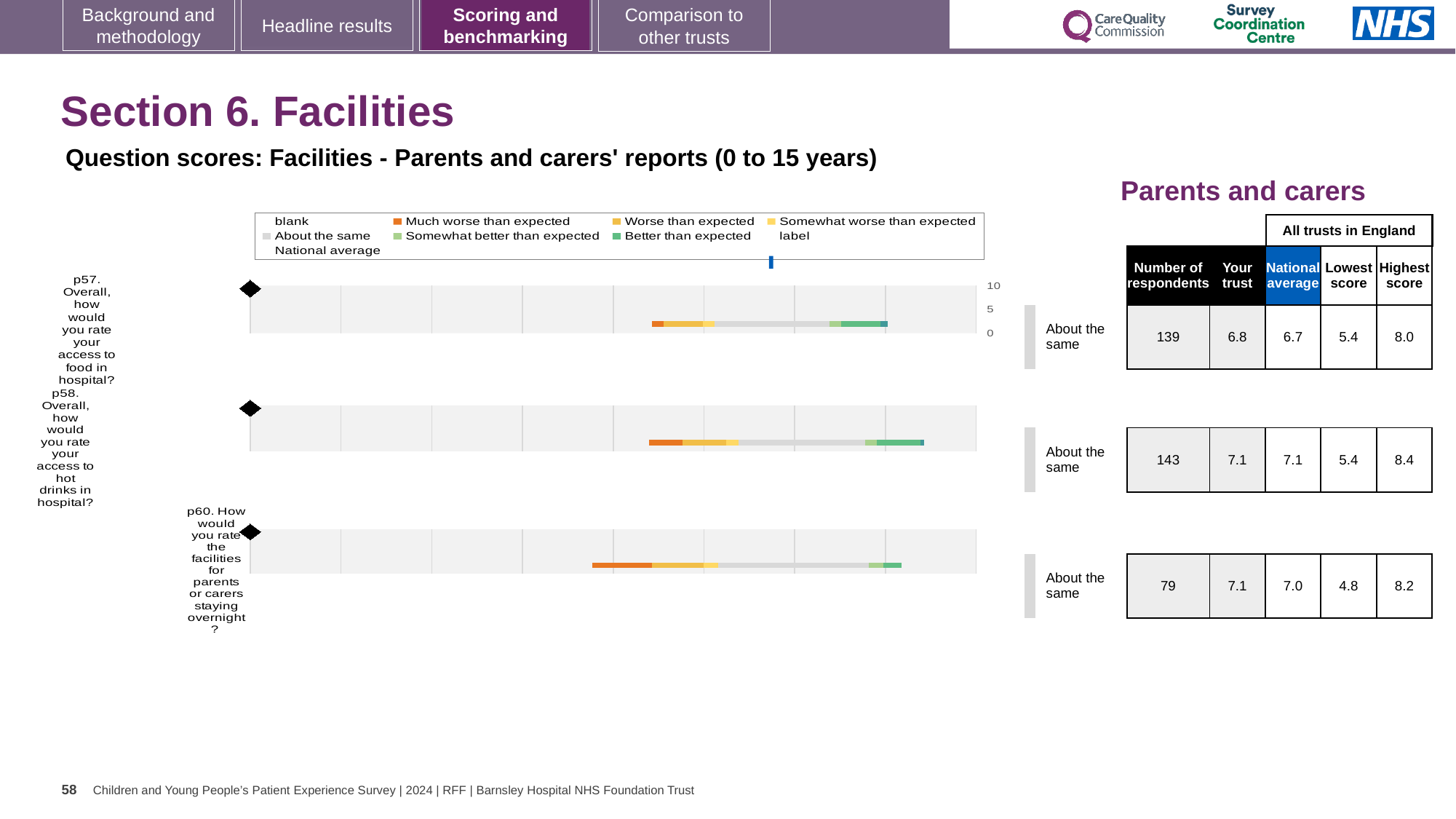
Which question has the lowest 'Lowest score' across all trusts in England? p60 How many survey questions are plotted on the slide? 3 How many respondents answered p60 (facilities for parents or carers staying overnight)? 79 What benchmark category is shown for p58 (access to hot drinks in hospital)? About the same Is the national average score for p60 greater or less than 5? greater What is the national average score for p58 (access to hot drinks in hospital)? 7.1 For p57, which is larger: the 'Your trust' score or the national average? Your trust What kind of chart is used to show the question scores for p57, p58 and p60? bar chart What is the 'Your trust' score for p57 (access to food in hospital)? 6.8 What is the title of the table to the right of the charts? Parents and carers For p57, what is the difference between the highest score and the lowest score across all trusts in England? 2.6 Which question has the highest 'Highest score' across all trusts in England? p58